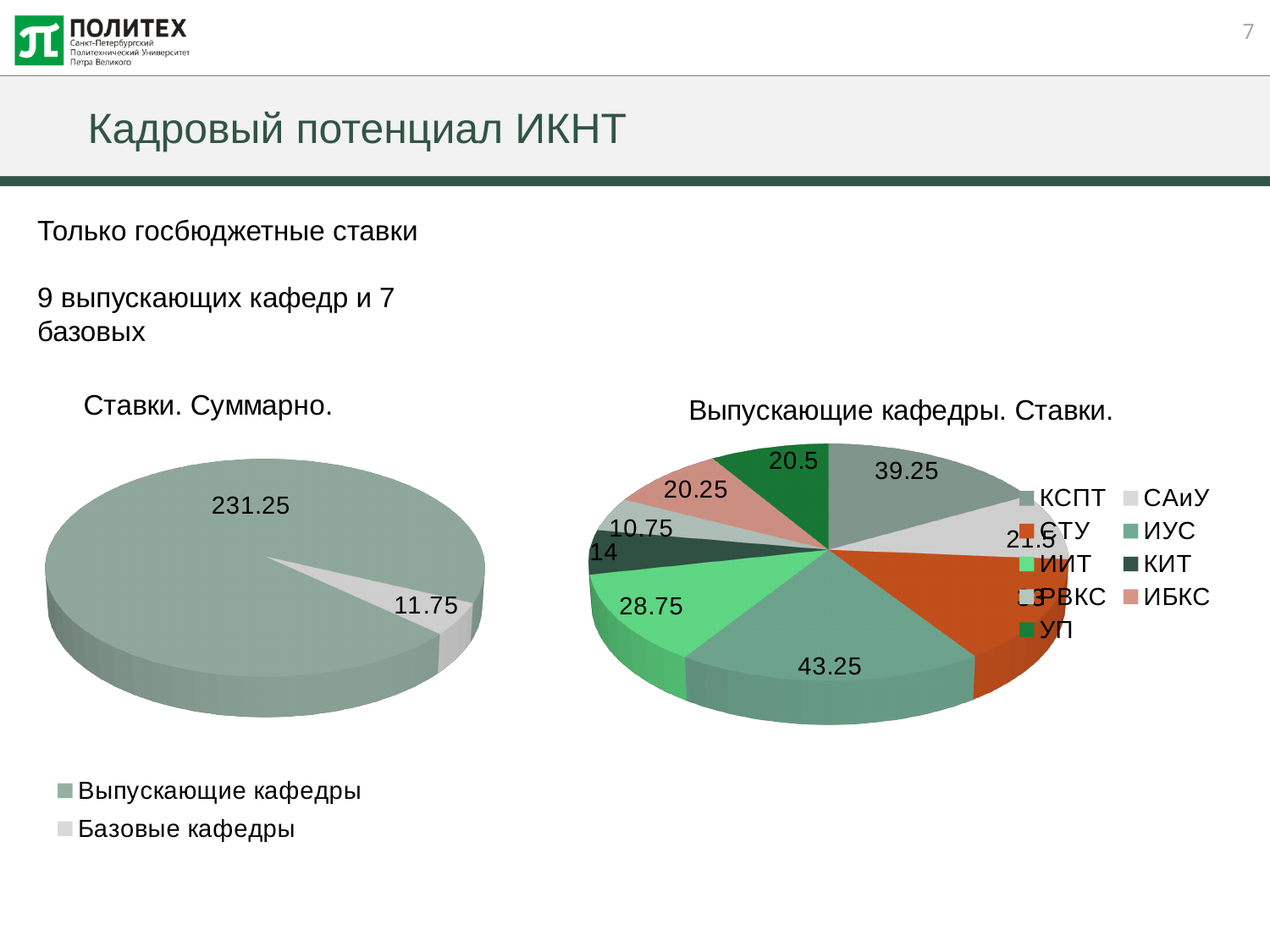
How many categories does the legend of the chart "Выпускающие кафедры. Ставки." list? 9 In the chart "Выпускающие кафедры. Ставки.", what is the value for КСПТ? 39.25 How many categories does the legend of the chart "Ставки. Суммарно." list? 2 In the chart "Ставки. Суммарно.", what is the difference between Выпускающие кафедры and Базовые кафедры? 219.5 In the chart "Ставки. Суммарно.", what is the value for Выпускающие кафедры? 231.25 What kind of chart is the left chart titled "Ставки. Суммарно."? pie chart In the chart "Выпускающие кафедры. Ставки.", which department has the smallest slice? РВКС In the chart "Выпускающие кафедры. Ставки.", what is the difference between КСПТ and САиУ? 17.75 In the chart "Выпускающие кафедры. Ставки.", what is the value for ИУС? 43.25 In the chart "Ставки. Суммарно.", what is the value for Базовые кафедры? 11.75 In the chart "Выпускающие кафедры. Ставки.", which is larger, ИИТ or УП? ИИТ In the chart "Выпускающие кафедры. Ставки.", which department has the largest slice? ИУС